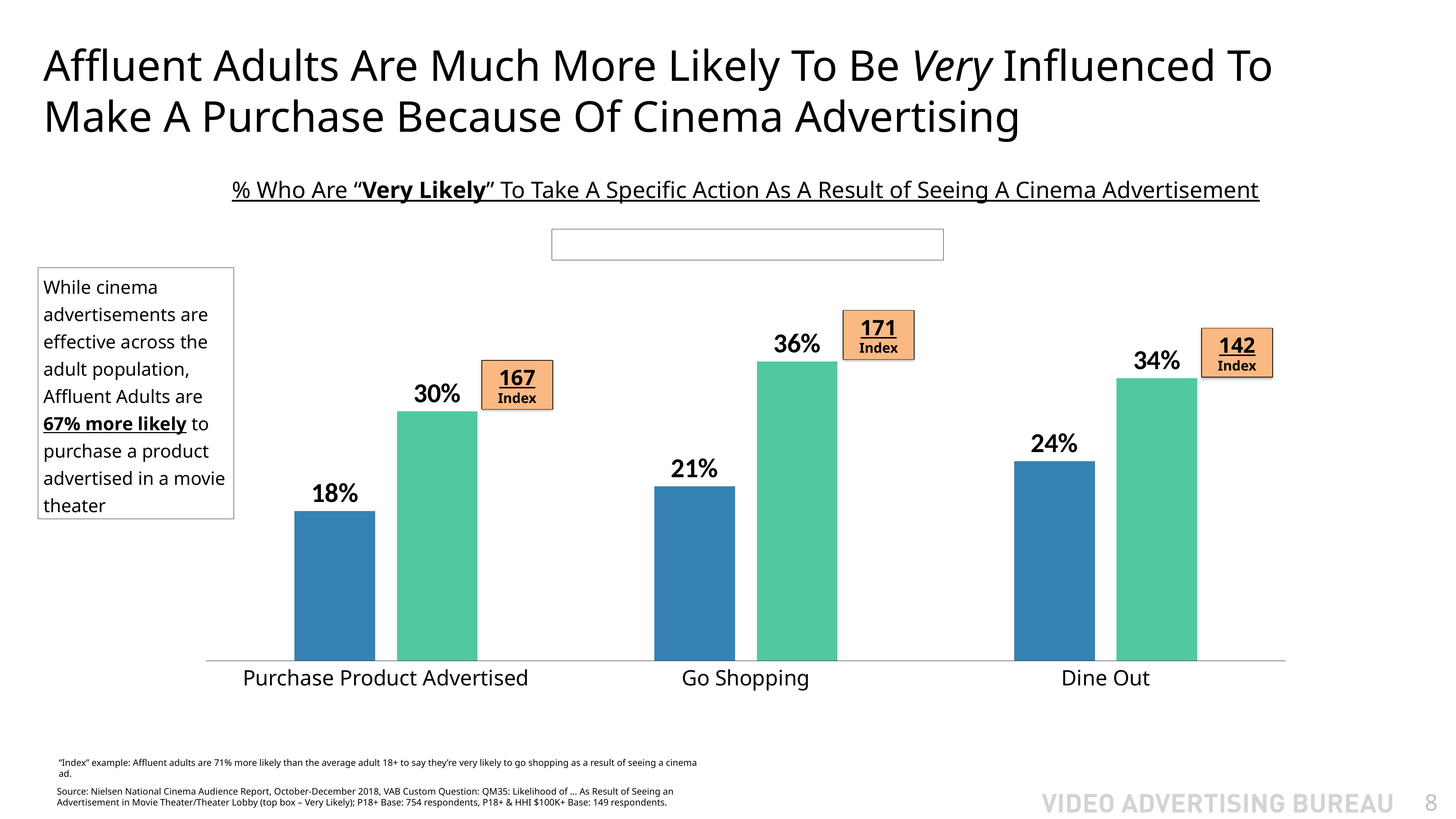
What is the value of the green bar for Purchase Product Advertised? 30% What kind of chart is shown on the slide? bar chart Which category has the lowest blue bar? Purchase Product Advertised Which is larger for Dine Out, the blue bar or the green bar? the green bar What is the value of the blue bar for Purchase Product Advertised? 18% What is the difference between the green bar and the blue bar for Go Shopping? 15% What is the value of the blue bar for Dine Out? 24% How many categories are shown on the x axis of the chart? 3 Which category has the highest green bar? Go Shopping What is the subtitle printed above the chart? % Who Are "Very Likely" To Take A Specific Action As A Result of Seeing A Cinema Advertisement What is the value of the green bar for Go Shopping? 36% What index value is shown next to the Dine Out green bar? 142